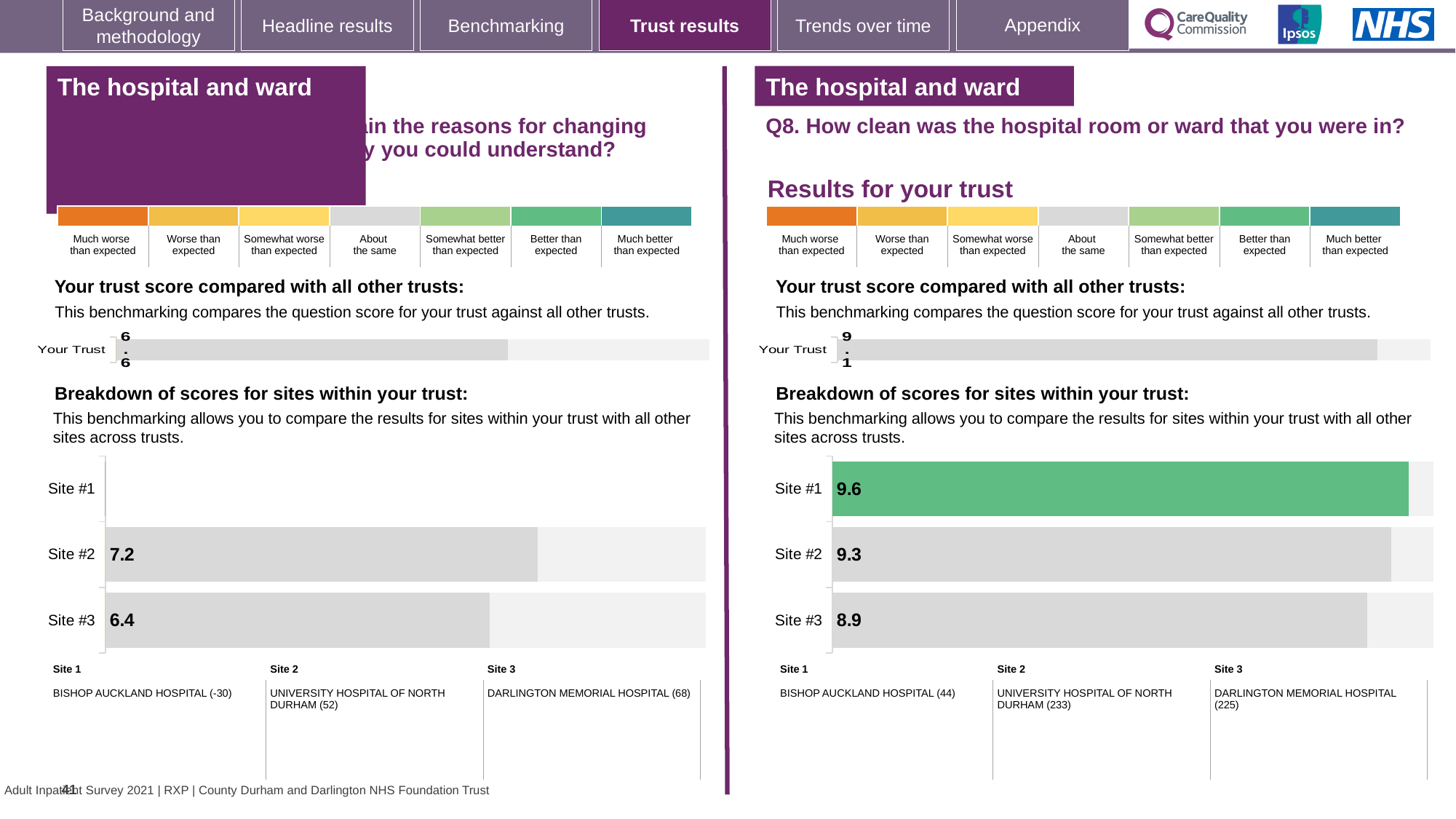
On the right-hand chart (Q8), which site has the highest score? Site #1 On the left-hand site breakdown chart, what is the score for Site #2? 7.2 On the right-hand chart (Q8), which site has the lowest score? Site #3 On the right-hand chart (Q8), which is larger: the score for Site #2 or Site #3? Site #2 On the left-hand site breakdown chart, what is the score for Site #3? 6.4 What kind of chart is used for the site breakdown on the right-hand side of the slide? Bar chart On the right-hand chart (Q8, how clean was the hospital room or ward), what is the score for Site #1? 9.6 On the right-hand chart (Q8), what is the 'Your Trust' score? 9.1 On the left-hand chart, what is the 'Your Trust' score? 6.6 On the right-hand chart (Q8), what is the difference between the Site #1 and Site #3 scores? 0.7 On the right-hand chart (Q8), what is the score for Site #3? 8.9 On the left-hand site breakdown chart, what is the difference between the Site #2 and Site #3 scores? 0.8